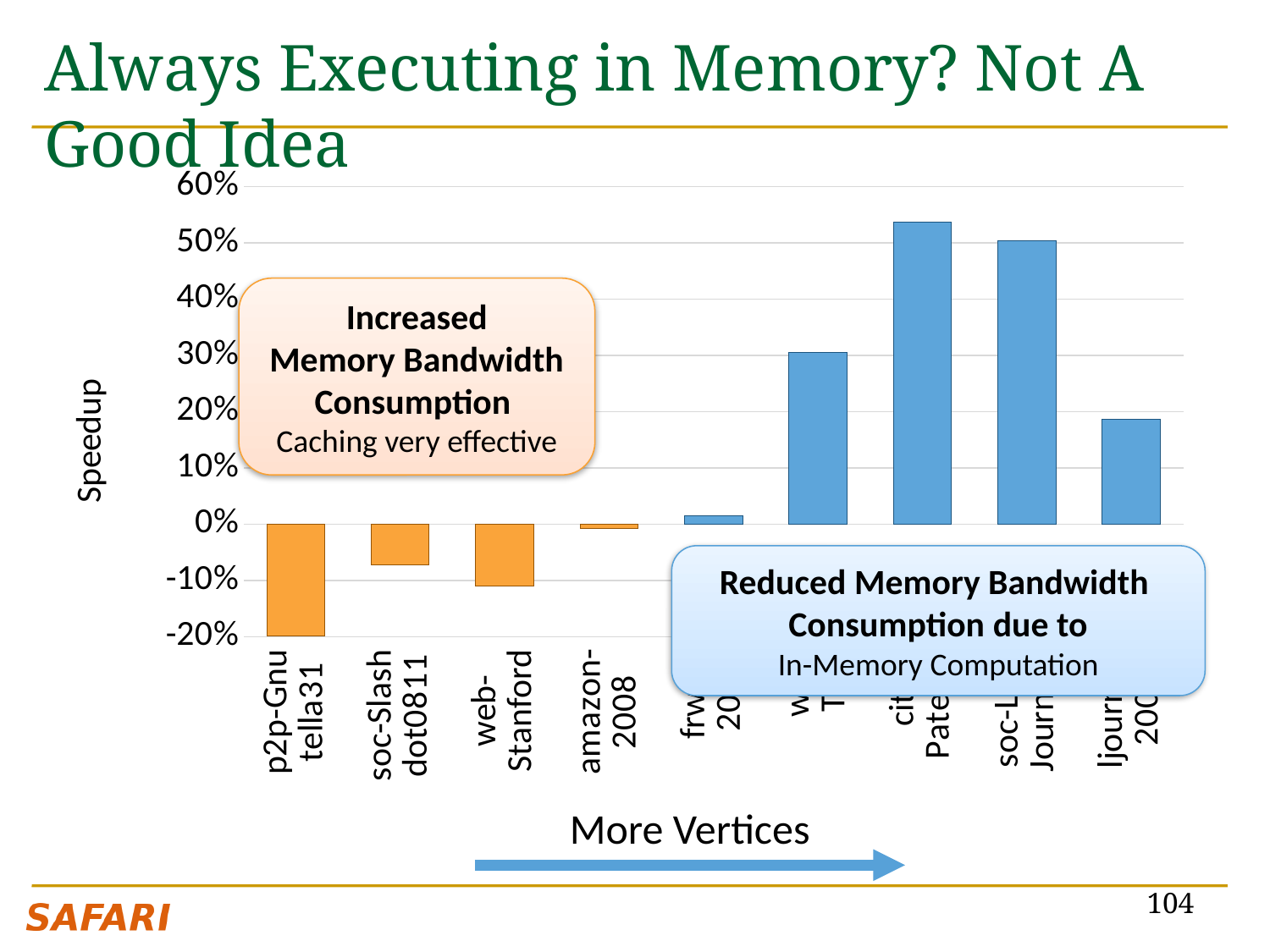
Which has the larger speedup, soc-Slashdot0811 or web-Stanford? soc-Slashdot0811 Is the speedup for web-Stanford greater or less than 0%? less How many bars (categories) are plotted in the chart? 9 What is the label on the vertical axis of the chart? Speedup Is the speedup for soc-Slashdot0811 greater or less than 0%? less Which has the larger speedup, amazon-2008 or p2p-Gnutella31? amazon-2008 Do the speedup values generally rise or fall moving left to right along the x axis? rise What kind of chart is shown on the slide? bar chart How many bars in the chart show a negative speedup? 4 Is the speedup for p2p-Gnutella31 greater or less than -10%? less Which category has the lowest speedup in the chart? p2p-Gnutella31